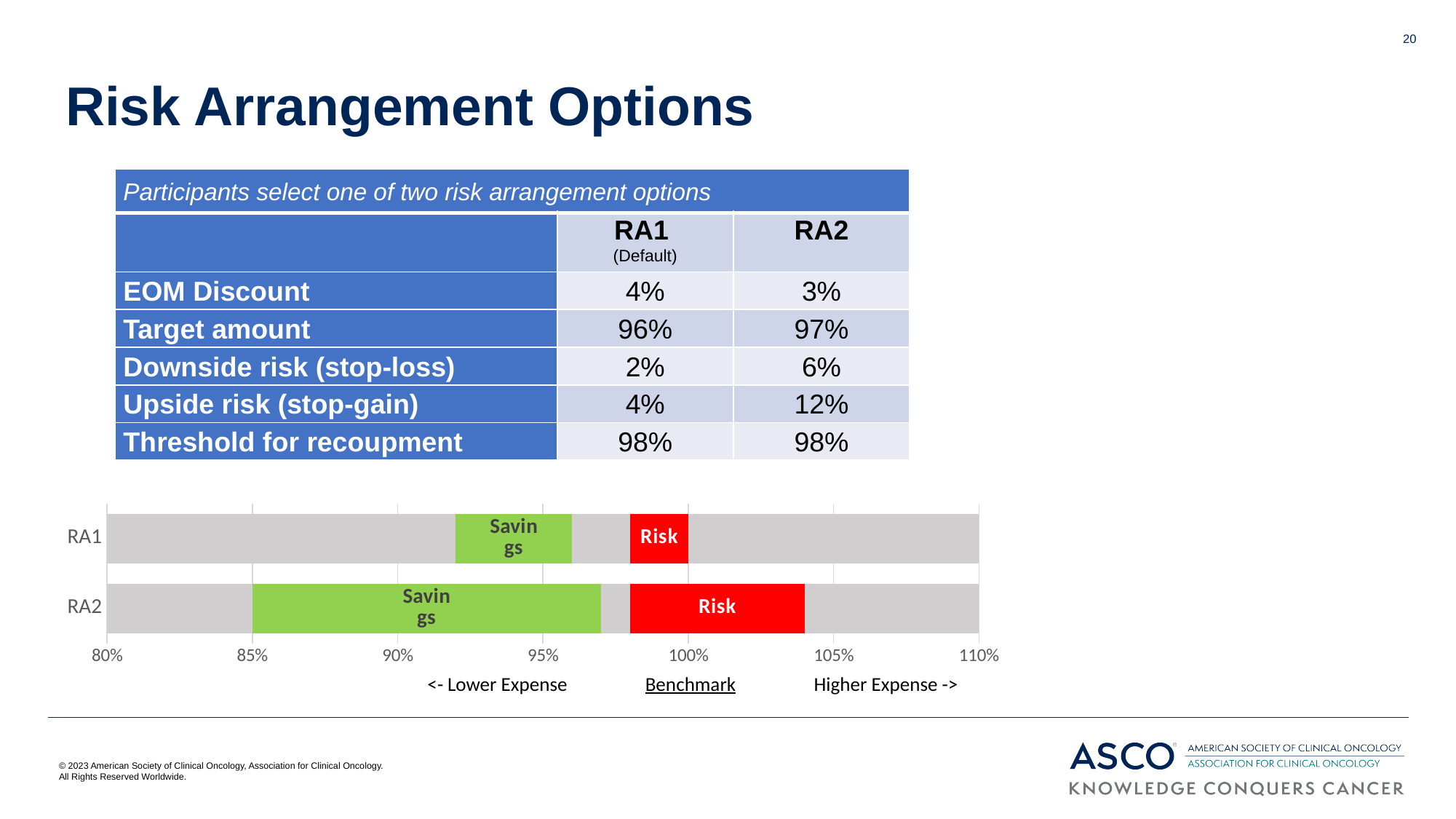
What are the two segment labels shown on the bars in the chart? Savings and Risk What label appears beneath the 100% tick on the chart's x axis? Benchmark Is the left end of the RA1 Savings bar greater or less than 90%? greater Which has the longer Risk bar, RA1 or RA2? RA2 What kind of chart is shown at the bottom of the slide? bar chart Is the left end of the RA2 Savings bar greater or less than 90%? less Which category has the shorter Savings bar? RA1 Which has the longer Savings bar, RA1 or RA2? RA2 Is the right end of the RA2 Risk bar greater or less than 100%? greater How many risk arrangement categories are plotted on the y axis of the chart? 2